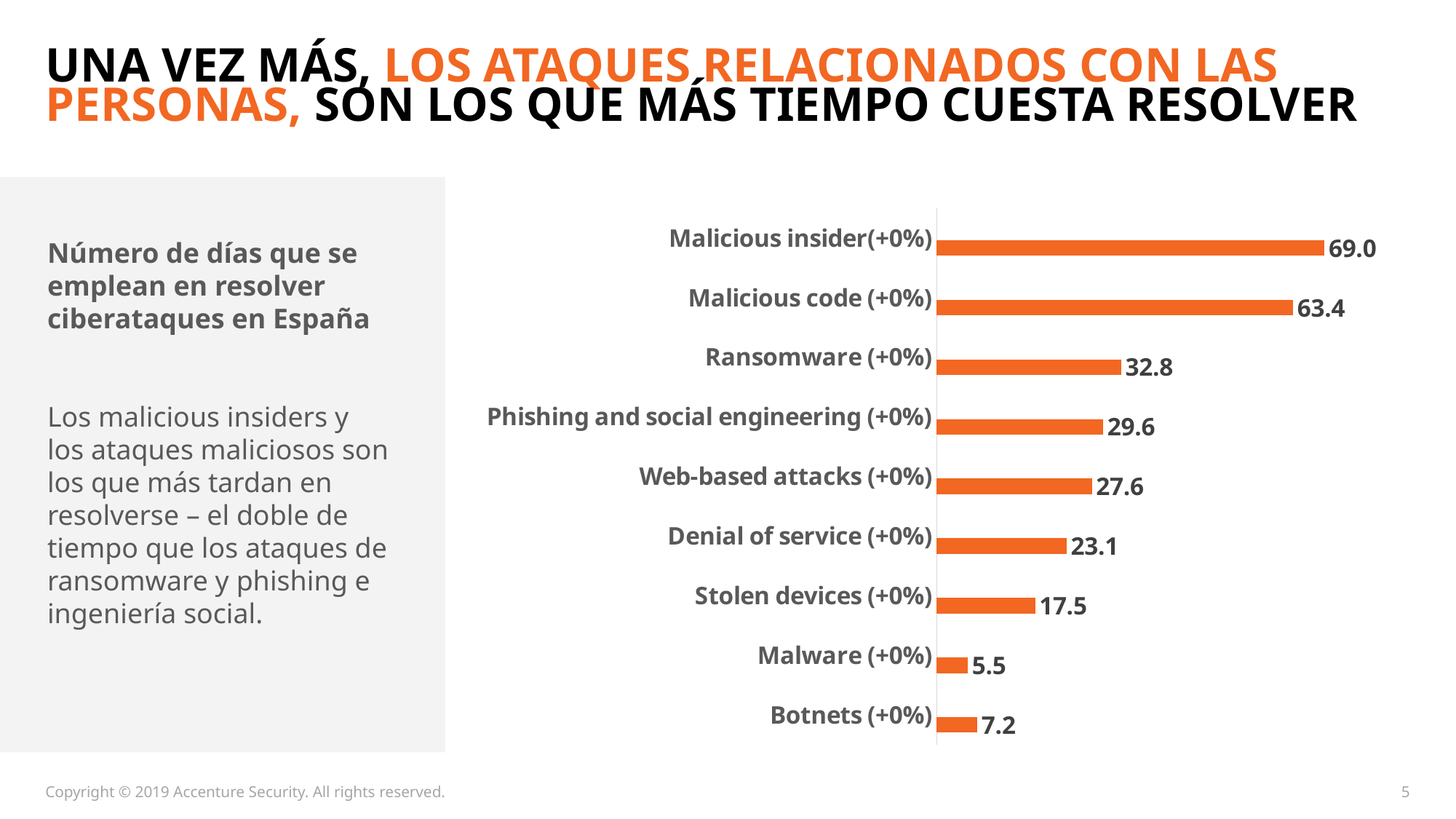
What kind of chart is shown on the slide? Bar chart What is the value for Malicious insider (+0%)? 69.0 What is the value for Botnets (+0%)? 7.2 How many categories are shown in the chart? 9 What is the difference between the values for Malicious insider (+0%) and Malicious code (+0%)? 5.6 What is the difference between the values for Ransomware (+0%) and Phishing and social engineering (+0%)? 3.2 Which category has the highest value? Malicious insider (+0%) What colour are the bars in the chart? Orange Which is larger, the value for Web-based attacks (+0%) or Denial of service (+0%)? Web-based attacks (+0%) What is the value for Stolen devices (+0%)? 17.5 Which category has the lowest value? Malware (+0%) What is the value for Ransomware (+0%)? 32.8